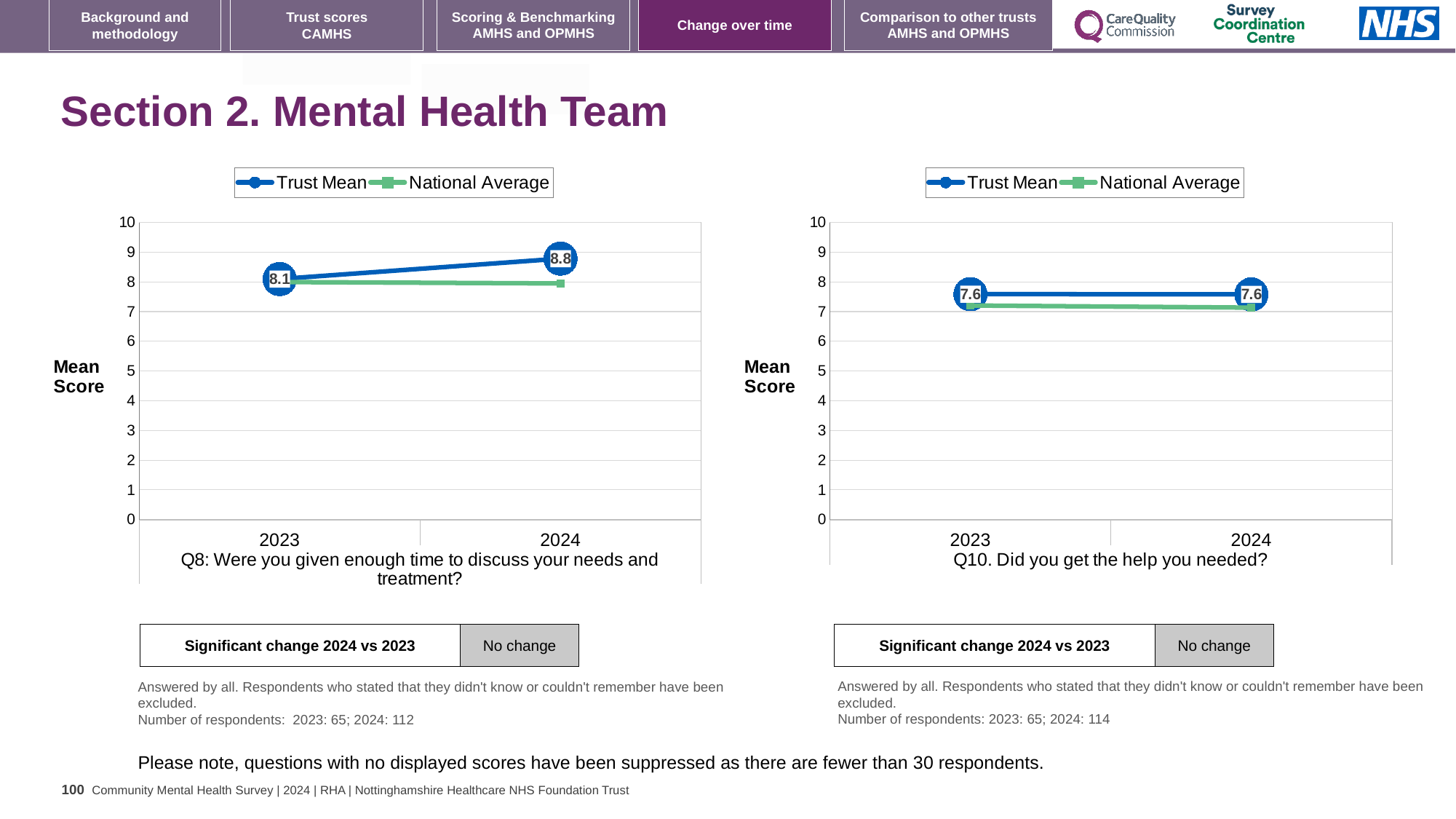
In the Q8 chart (left), does the Trust Mean rise or fall from 2023 to 2024? rise In the Q10 chart (right), what is the Trust Mean for 2023? 7.6 What kind of chart is the Q8 chart (left)? line chart In the Q8 chart (left), what is the Trust Mean for 2024? 8.8 In the Q8 chart (left), what is the Trust Mean for 2023? 8.1 How many series does the legend of the Q10 chart (right) list? 2 In the Q8 chart (left), by how much did the Trust Mean change from 2023 to 2024? 0.7 In the Q8 chart (left), which year has the higher Trust Mean? 2024 In the Q8 chart (left), is the Trust Mean or the National Average higher in 2024? Trust Mean In the Q8 chart (left), is the National Average for 2023 greater or less than 7? greater In the Q10 chart (right), is the National Average for 2024 greater or less than 8? less In the Q10 chart (right), does the Trust Mean rise, fall or stay the same from 2023 to 2024? stay the same